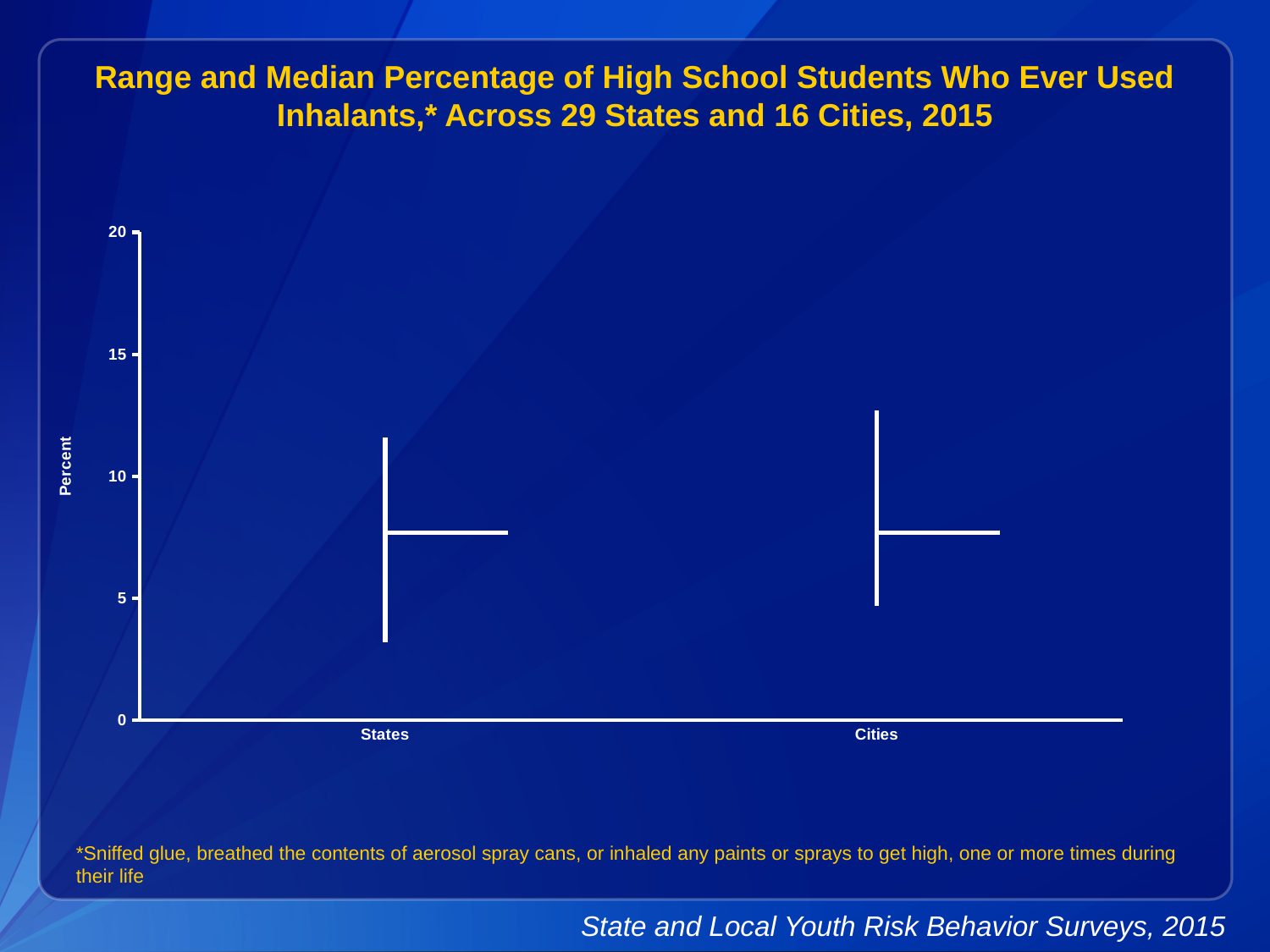
Is the bottom of the range for States greater or less than 5? less Which category has the lower bottom of its range, States or Cities? States Which category has the higher top of its range, States or Cities? Cities Is the median value for States greater or less than 10? less Is the median value for States greater or less than 5? greater How many categories are shown on the x axis of the chart? 2 What is the label on the vertical axis of the chart? Percent What are the two categories shown on the x axis? States and Cities